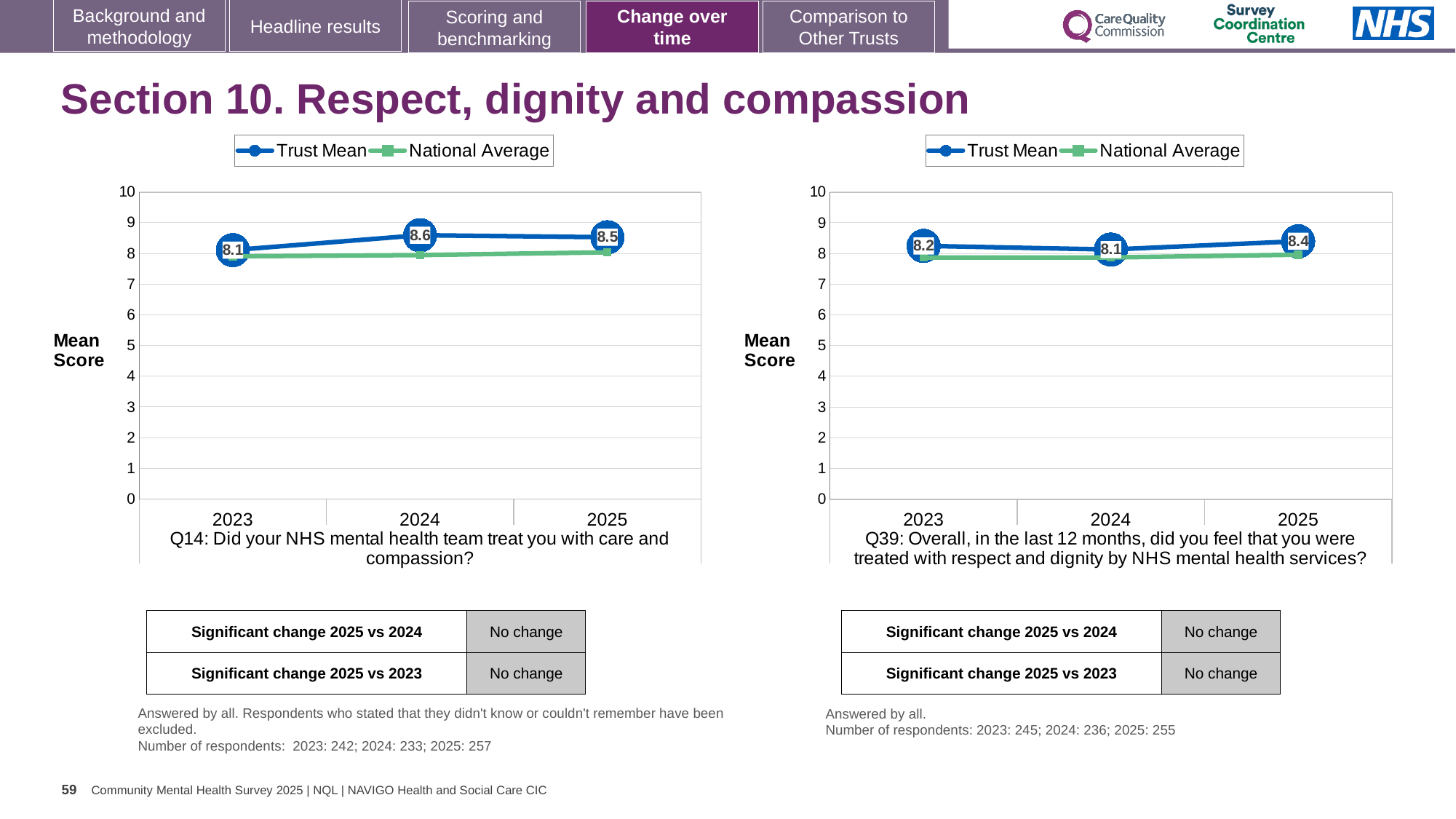
In the Q39 chart on the right, what is the Trust Mean score for 2025? 8.4 In the Q14 chart on the left, what is the Trust Mean score for 2023? 8.1 How many series does the legend of the Q14 chart on the left list? 2 In the Q14 chart on the left, is the National Average value for 2023 greater or less than 9? less In the Q14 chart on the left, what is the difference between the Trust Mean scores for 2024 and 2023? 0.5 In the Q39 chart on the right, is the Trust Mean score higher in 2023 or 2025? 2025 In the Q14 chart on the left, which year has the highest Trust Mean score? 2024 In the Q39 chart on the right, which year has the lowest Trust Mean score? 2024 How many years are plotted on the x axis of the Q39 chart on the right? 3 In the Q14 chart on the left, what is the Trust Mean score for 2024? 8.6 What kind of chart is the Q14 chart on the left? Line chart In the Q39 chart on the right, what is the difference between the Trust Mean scores for 2025 and 2024? 0.3